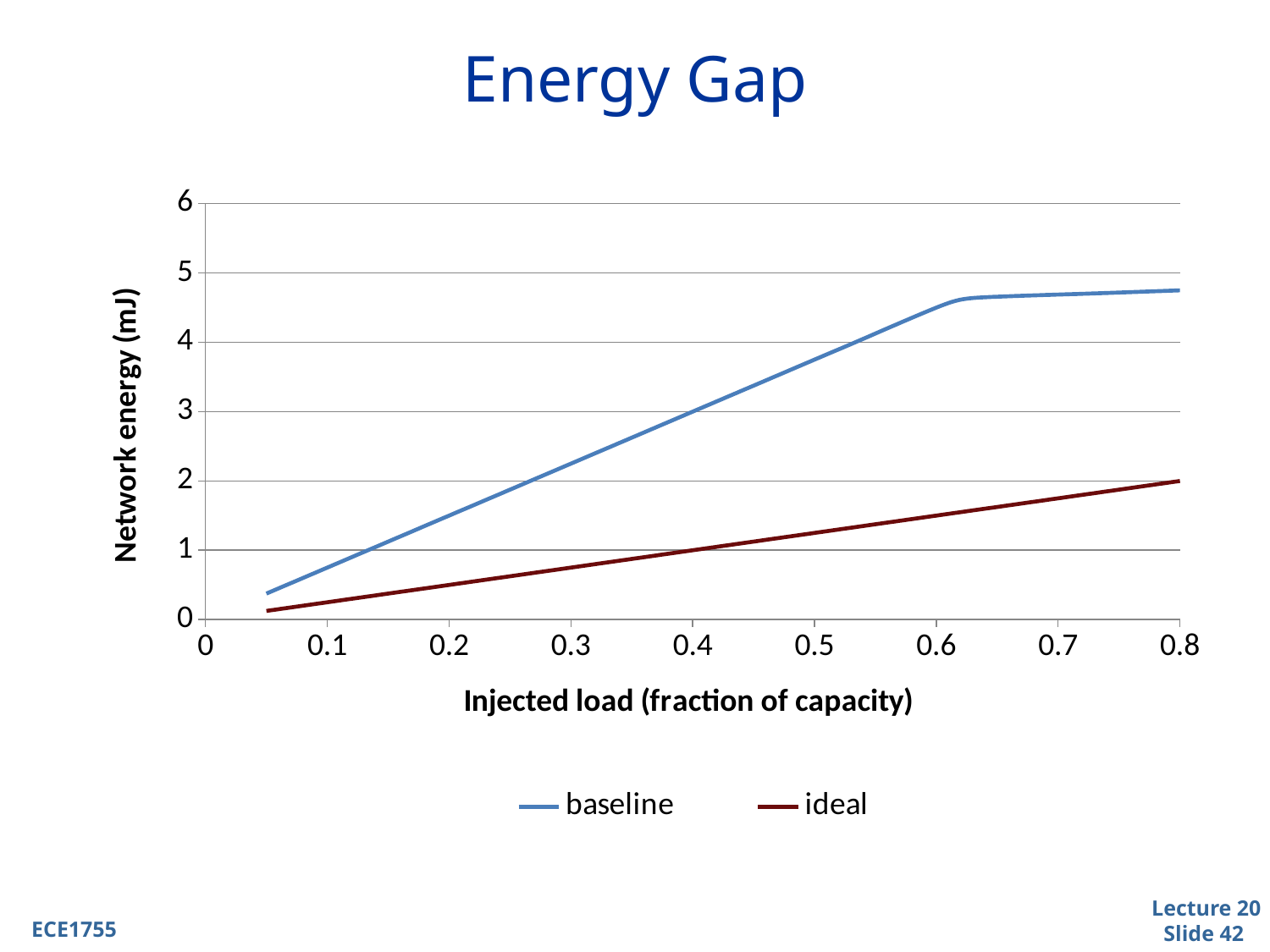
How many series does the legend list? 2 Is the baseline value at an injected load of 0.5 greater or less than 4? less Does the baseline series rise or fall as injected load increases from 0.1 to 0.6? rise What is the label of the y axis? Network energy (mJ) At an injected load of 0.5, which series has the higher network energy, baseline or ideal? baseline Does the ideal series rise or fall as injected load increases? rise What kind of chart is shown on the slide? line chart Is the ideal value at an injected load of 0.6 greater or less than 2? less Which series reaches the highest network energy on the chart? baseline Is the baseline value at an injected load of 0.3 greater or less than 2? greater What is the title of the chart? Energy Gap